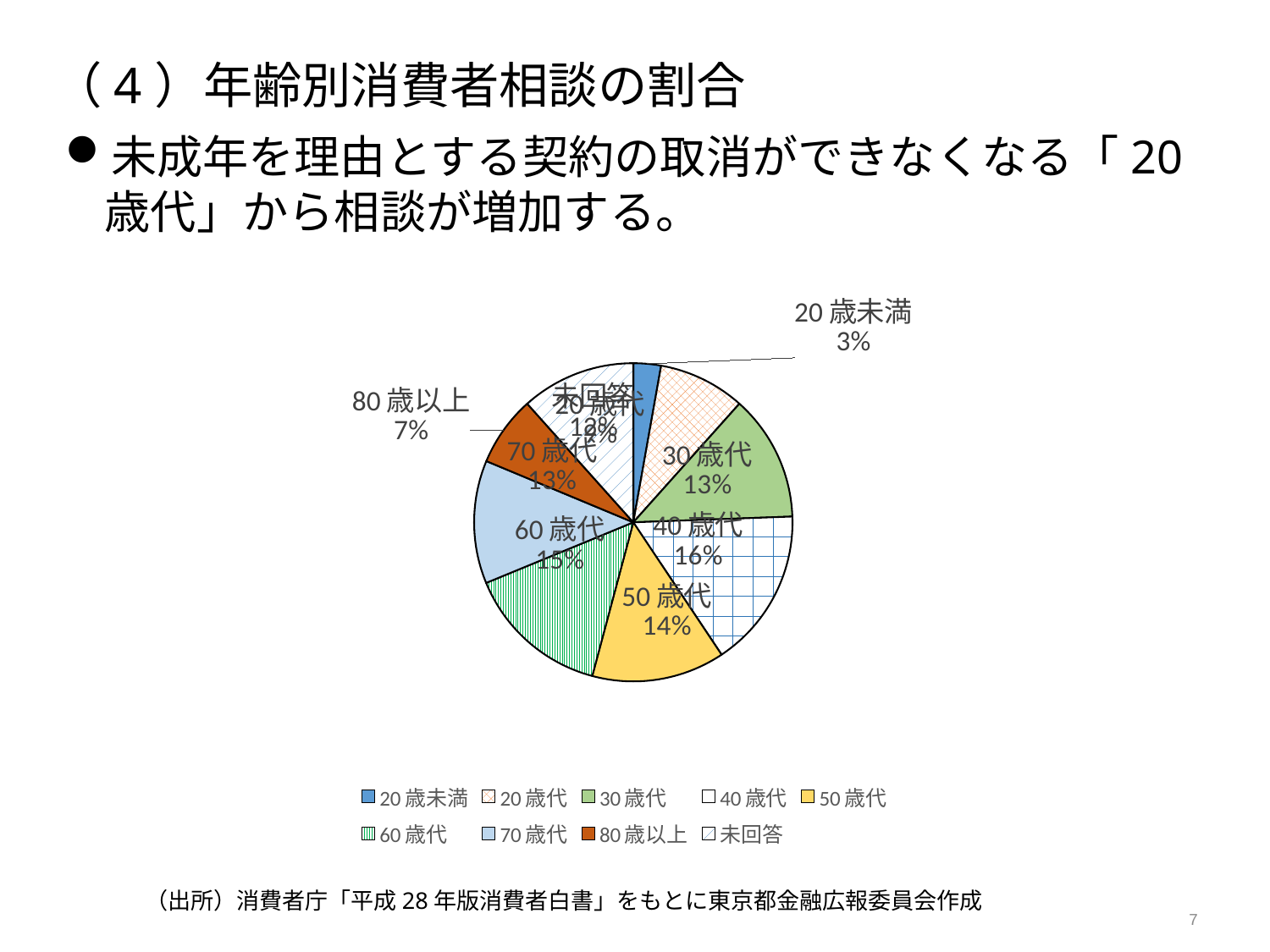
Which age category has the largest share of the pie? 40歳代 What is the value shown for 60歳代? 15% Which has a larger share, 60歳代 or 30歳代? 60歳代 What share of the pie does 20歳未満 represent? 3% What is the title of the chart section on the slide? （４）年齢別消費者相談の割合 How many categories does the legend list? 9 Which age category has the smallest share of the pie? 20歳未満 What is the value shown for 40歳代? 16% What is the difference between the shares of 40歳代 and 80歳以上? 9% What is the value shown for 80歳以上? 7% What is the value shown for 50歳代? 14% What kind of chart is shown on the slide? pie chart